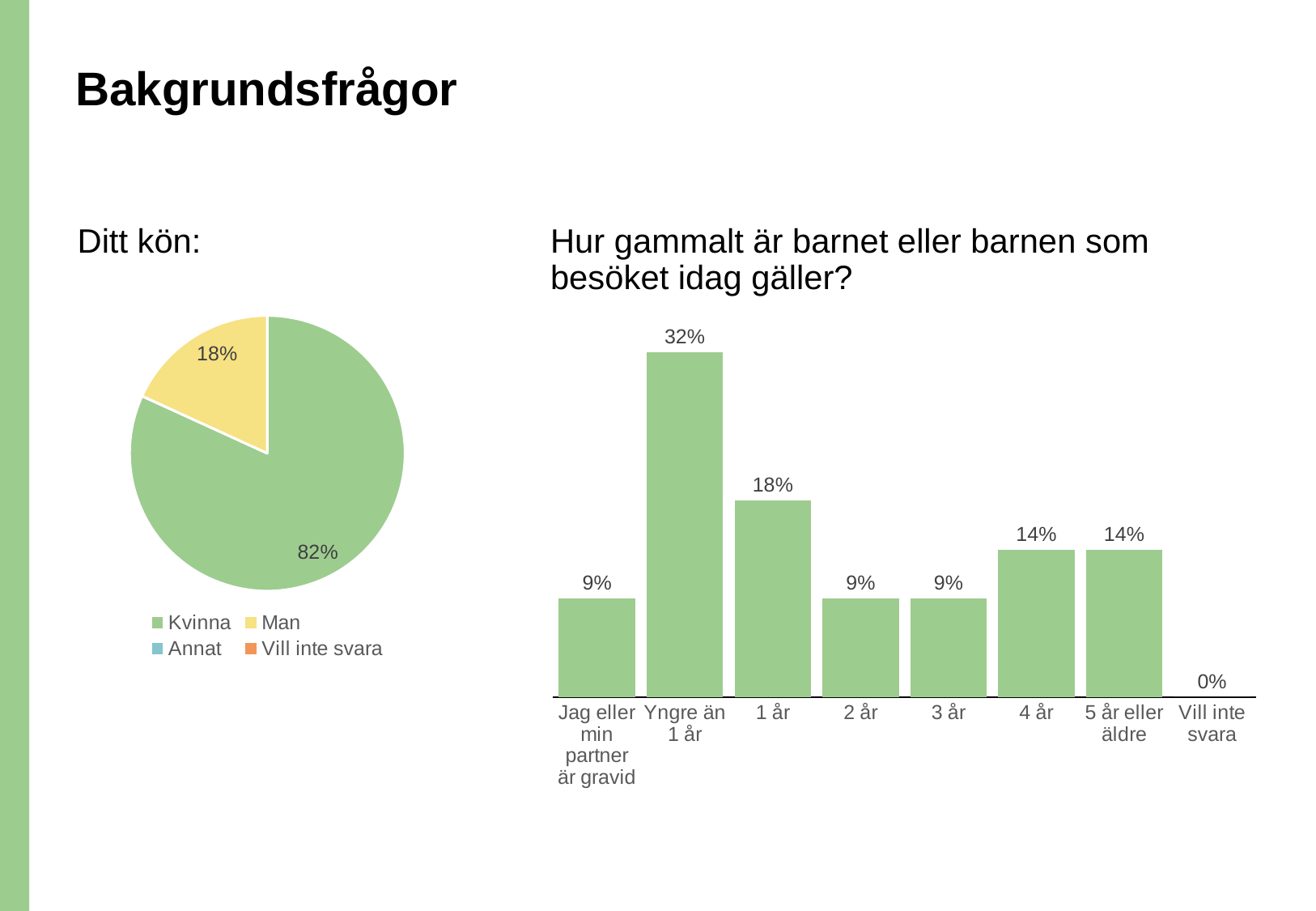
How many categories are shown in the bar chart 'Hur gammalt är barnet eller barnen som besöket idag gäller?'? 8 In the bar chart 'Hur gammalt är barnet eller barnen som besöket idag gäller?', what is the value for 'Yngre än 1 år'? 32% How many entries does the legend of the pie chart 'Ditt kön:' list? 4 In the pie chart 'Ditt kön:', what share is Kvinna? 82% In the bar chart 'Hur gammalt är barnet eller barnen som besöket idag gäller?', which is larger: '4 år' or '3 år'? 4 år In the pie chart 'Ditt kön:', what share is Man? 18% In the bar chart 'Hur gammalt är barnet eller barnen som besöket idag gäller?', which category has the highest value? Yngre än 1 år What kind of chart is the chart on the left of the slide, 'Ditt kön:'? pie chart What kind of chart is the chart on the right, 'Hur gammalt är barnet eller barnen som besöket idag gäller?'? bar chart In the bar chart 'Hur gammalt är barnet eller barnen som besöket idag gäller?', which category has the lowest value? Vill inte svara In the bar chart 'Hur gammalt är barnet eller barnen som besöket idag gäller?', what is the difference between 'Yngre än 1 år' and '1 år'? 14% In the bar chart 'Hur gammalt är barnet eller barnen som besöket idag gäller?', what is the value for '1 år'? 18%